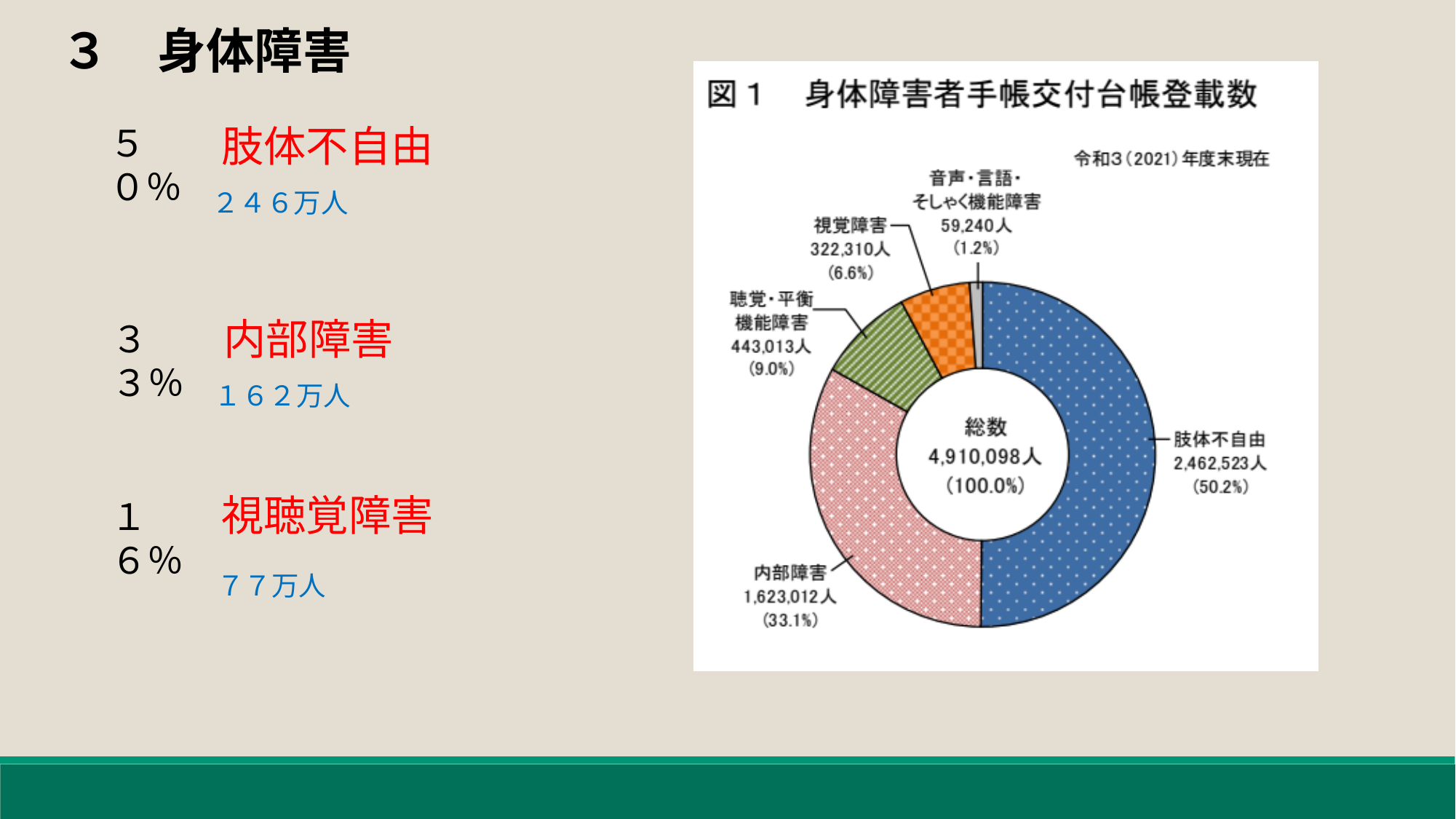
What is the number of people for 内部障害 in the donut chart? 1,623,012人 What is the difference in number of people between 肢体不自由 and 内部障害 in the donut chart? 839,511人 Which category has the largest share in the donut chart? 肢体不自由 How many categories are shown in the donut chart? 5 Which category has the smallest share in the donut chart? 音声・言語・そしゃく機能障害 What percentage share does 音声・言語・そしゃく機能障害 have in the donut chart? 1.2% What is the number of people for 聴覚・平衡機能障害 in the donut chart? 443,013人 Which is larger in the donut chart, 視覚障害 or 聴覚・平衡機能障害? 聴覚・平衡機能障害 What is the number of people for 肢体不自由 in the donut chart? 2,462,523人 What kind of chart is shown in 図1 身体障害者手帳交付台帳登載数? Pie chart (donut) What percentage share does 視覚障害 have in the donut chart? 6.6% What is the total (総数) shown in the centre of the donut chart? 4,910,098人